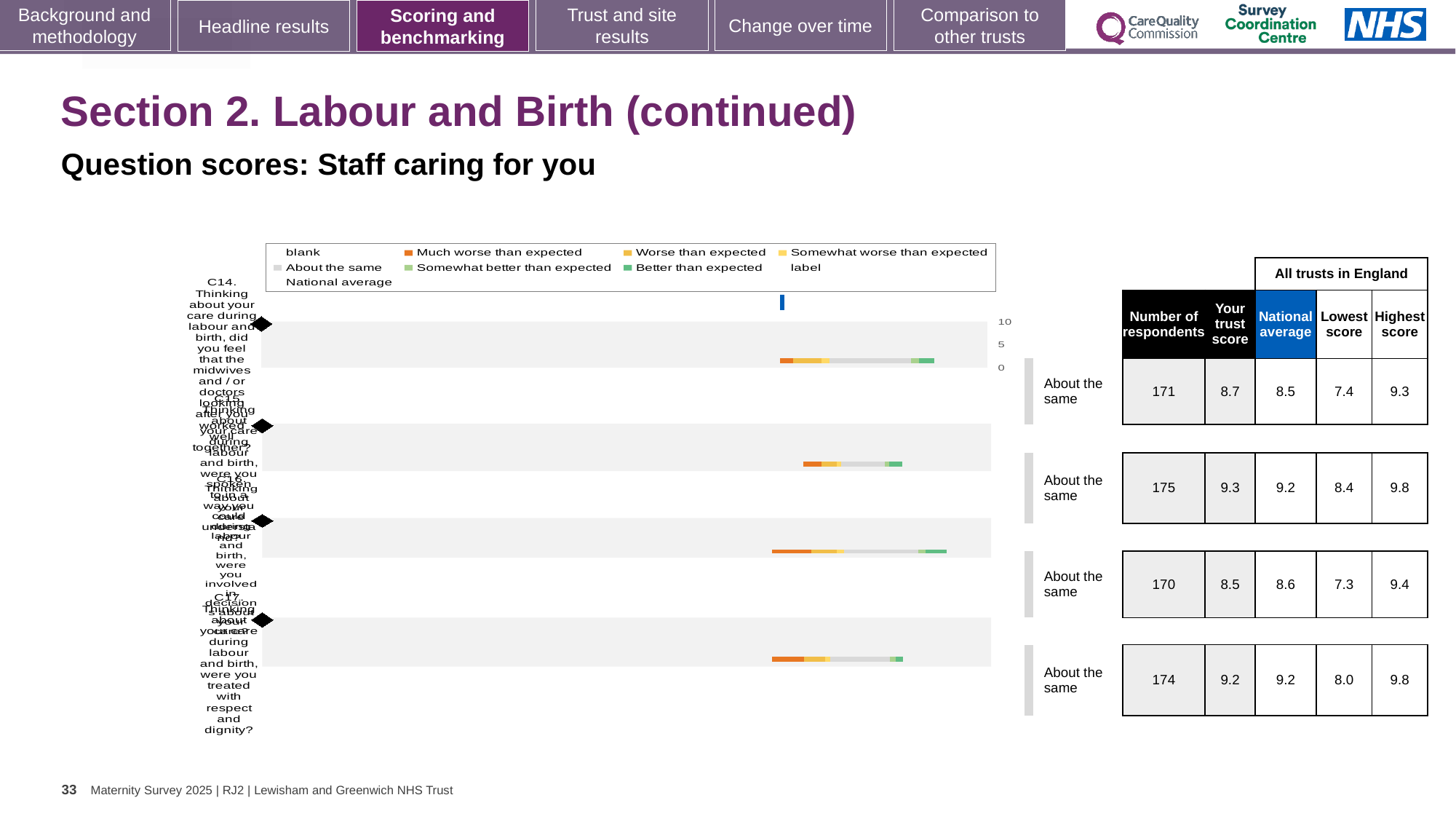
For the first row (C14), which is larger: the trust score or the national average? the trust score (8.7) In the table beside the chart, which row has the highest 'Your trust score'? the second row (9.3) In the table beside the chart, how many respondents are listed for the first row (C14)? 171 For the second row, what is the difference between the highest score (9.8) and the lowest score (8.4)? 1.4 What kind of chart is shown on the slide? bar chart How many entries does the chart's legend list? 9 In the table beside the chart, which row has the lowest 'Lowest score' value? the third row (7.3) How many question rows (bars) does the chart show? 4 In the table beside the chart, what is the national average for the last row (C17)? 9.2 In the table beside the chart, what is the 'Your trust score' for the first row (C14)? 8.7 What colour does the legend use for 'Much worse than expected'? orange What colour does the legend use for 'Better than expected'? green